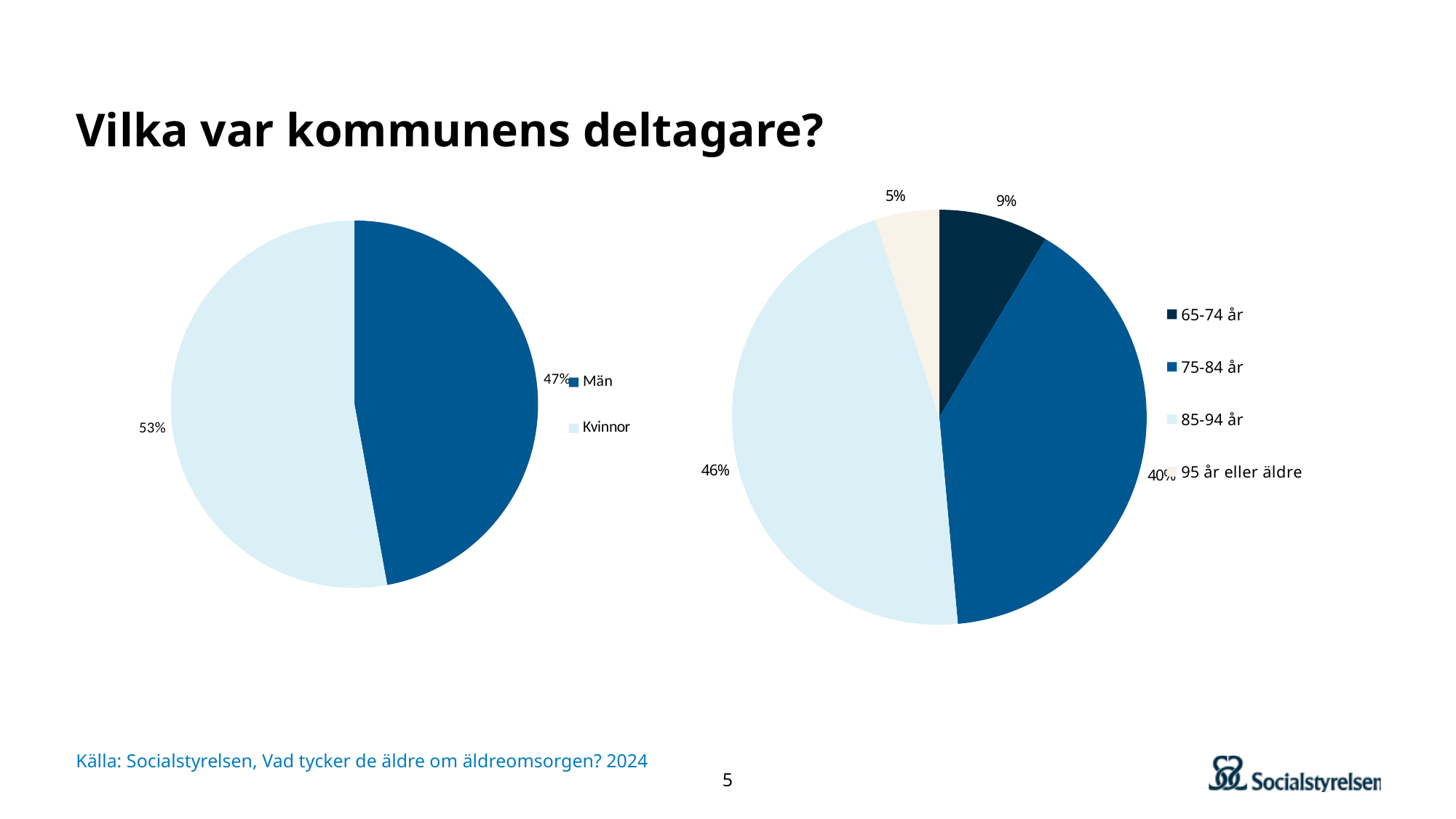
How many entries does the legend of the left pie chart list? 2 In the left pie chart, what share of participants were Kvinnor? 53% What kind of chart is the left chart on the slide? pie chart In the right pie chart, which age group has the largest share? 85-94 år In the left pie chart, which slice is larger, Män or Kvinnor? Kvinnor In the right pie chart, what share of participants were 65-74 år? 9% In the left pie chart, what share of participants were Män? 47% In the left pie chart, what is the difference in percentage points between Kvinnor and Män? 6 In the right pie chart, which age group has the smallest share? 95 år eller äldre How many age groups are shown in the right pie chart? 4 In the right pie chart, what share of participants were 95 år eller äldre? 5% In the right pie chart, what share of participants were 85-94 år? 46%